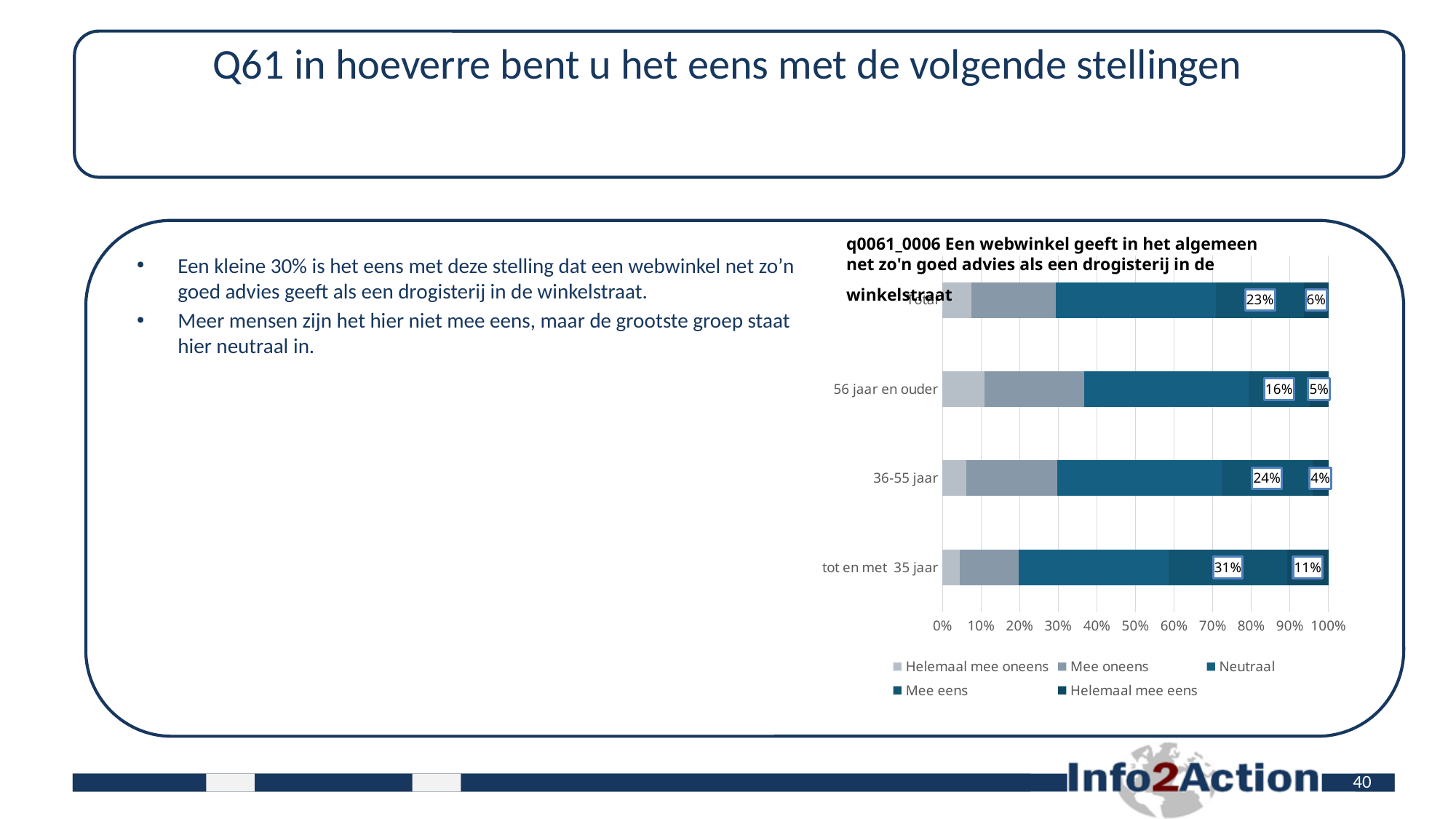
Which age group has the lowest 'Helemaal mee eens' percentage? 36-55 jaar What percentage of respondents aged 'tot en met 35 jaar' answered 'Mee eens'? 31% How many categories (bars) are shown in the chart? 4 How many series does the chart legend list? 5 Which age group has the highest 'Mee eens' percentage? tot en met 35 jaar Is the 'Neutraal' value for 'tot en met 35 jaar' greater or less than 30%? greater What is the combined share of 'Mee eens' and 'Helemaal mee eens' for the 'tot en met 35 jaar' group? 42% What type of chart is shown on the slide? Stacked bar chart Which group has a larger 'Helemaal mee eens' share: 'tot en met 35 jaar' or '56 jaar en ouder'? tot en met 35 jaar What is the 'Mee eens' value for the '36-55 jaar' group? 24% How many percentage points higher is the 'Mee eens' value for 'tot en met 35 jaar' than for '56 jaar en ouder'? 15 percentage points What is the 'Helemaal mee eens' value for the '56 jaar en ouder' group? 5%